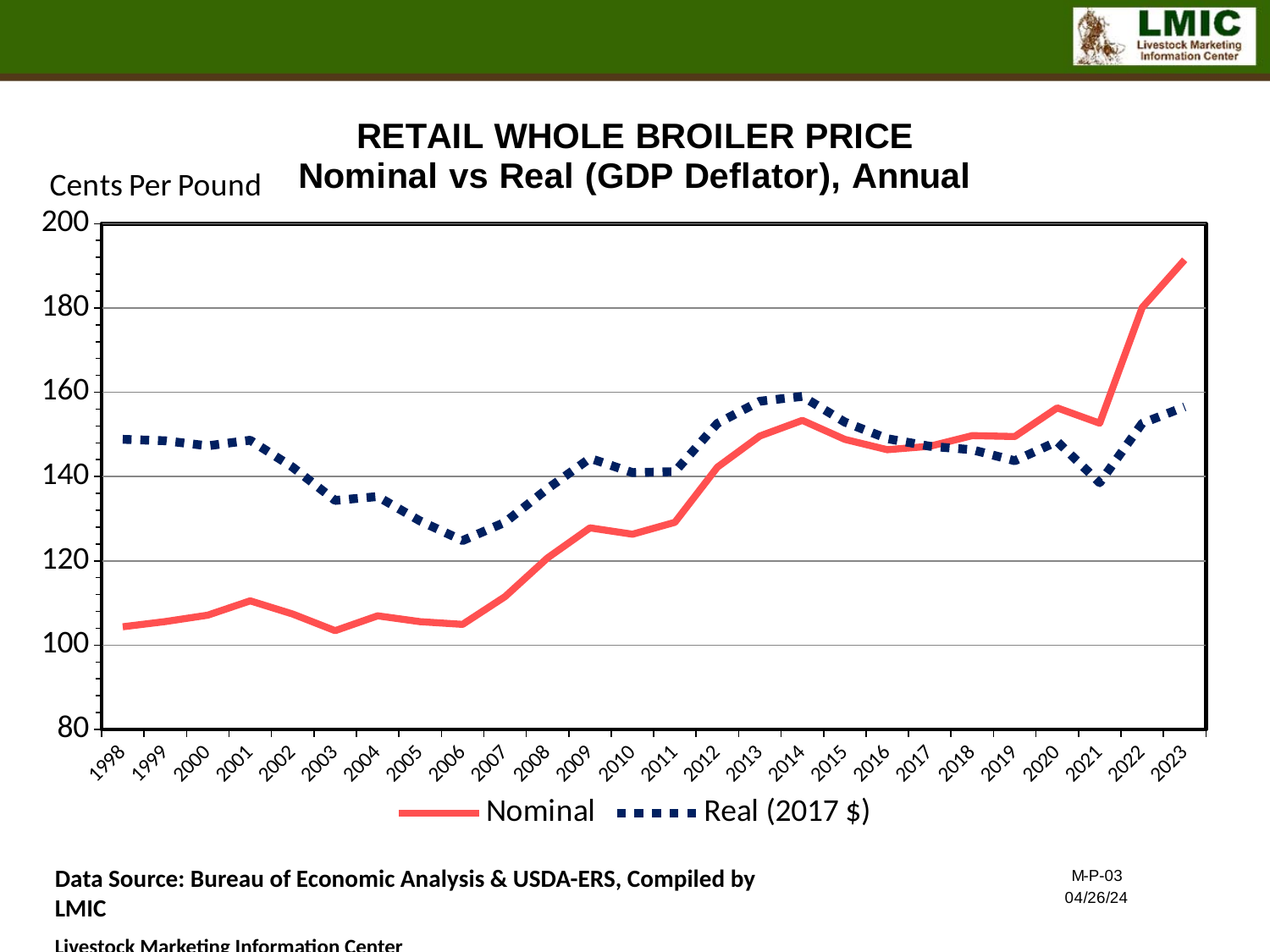
What type of chart is shown on the slide? Line chart In 2010, which series has the larger value, Nominal or Real (2017 $)? Real (2017 $) Is the Nominal value for 2023 greater or less than 180? greater What is the title of the chart? RETAIL WHOLE BROILER PRICE Nominal vs Real (GDP Deflator), Annual In which year does the Nominal series reach its highest value? 2023 What unit is shown on the y axis label? Cents Per Pound How many series does the legend list? 2 Does the Nominal series rise or fall from 2019 to 2023? rise Is the Nominal value for 1998 greater or less than 120? less How many years are plotted along the x axis? 26 In which year does the Real (2017 $) series reach its lowest value? 2006 Is the Real (2017 $) value for 2006 greater or less than 140? less